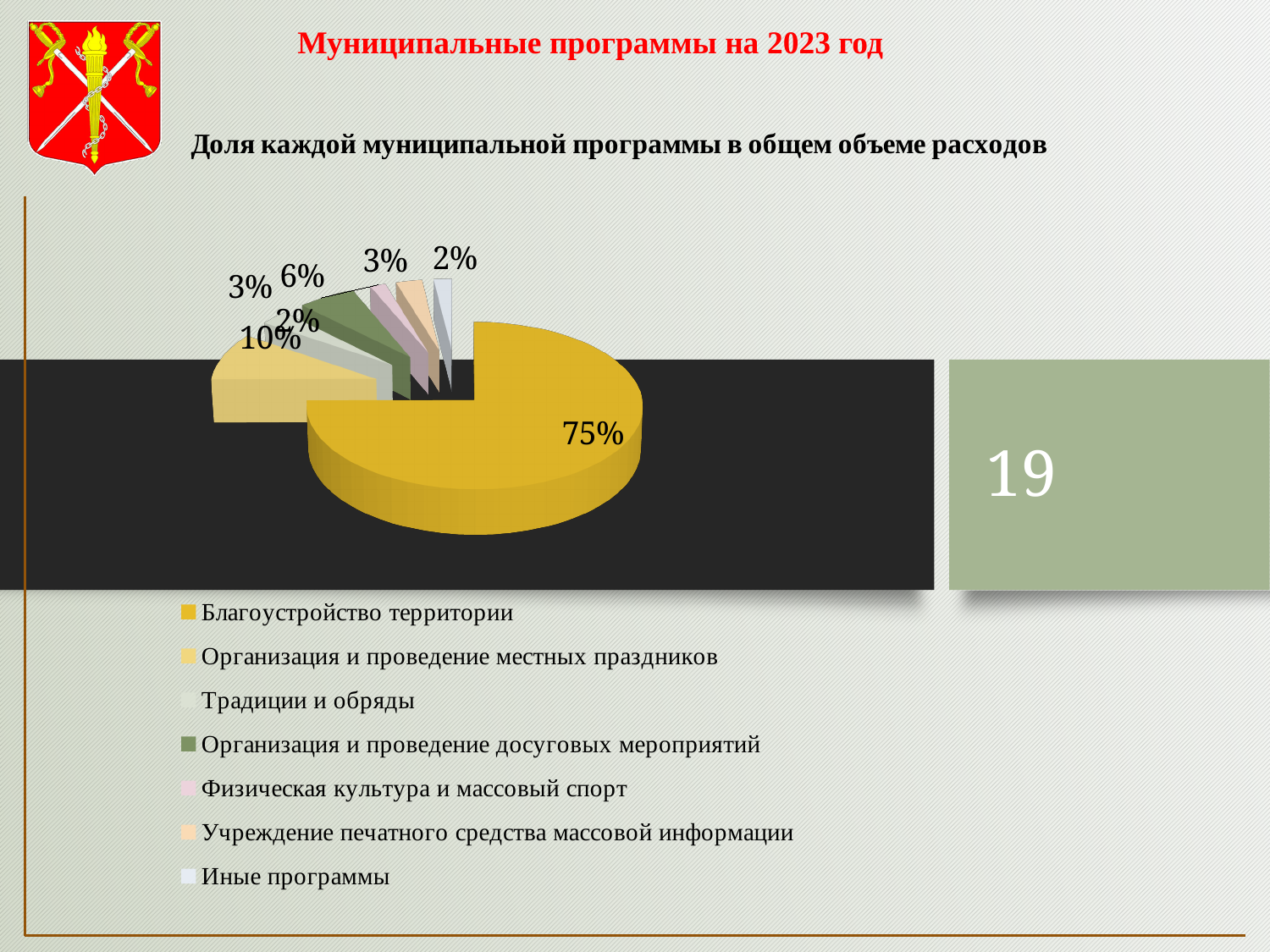
By how many percentage points does the share for Благоустройство территории exceed the share for Организация и проведение местных праздников? 65 percentage points Is the share for Благоустройство территории greater or less than 50%? greater What type of chart is shown on the slide? pie chart What share of total expenditure does Организация и проведение местных праздников account for? 10% What is the last entry in the chart legend? Иные программы Which programme has the largest share of expenditure? Благоустройство территории Which is larger: the share for Благоустройство территории or for Организация и проведение местных праздников? Благоустройство территории What share of total expenditure does Организация и проведение досуговых мероприятий account for? 6% What share of total expenditure does Благоустройство территории account for? 75% What is the subtitle describing the chart? Доля каждой муниципальной программы в общем объеме расходов How many programmes are listed in the chart legend? 7